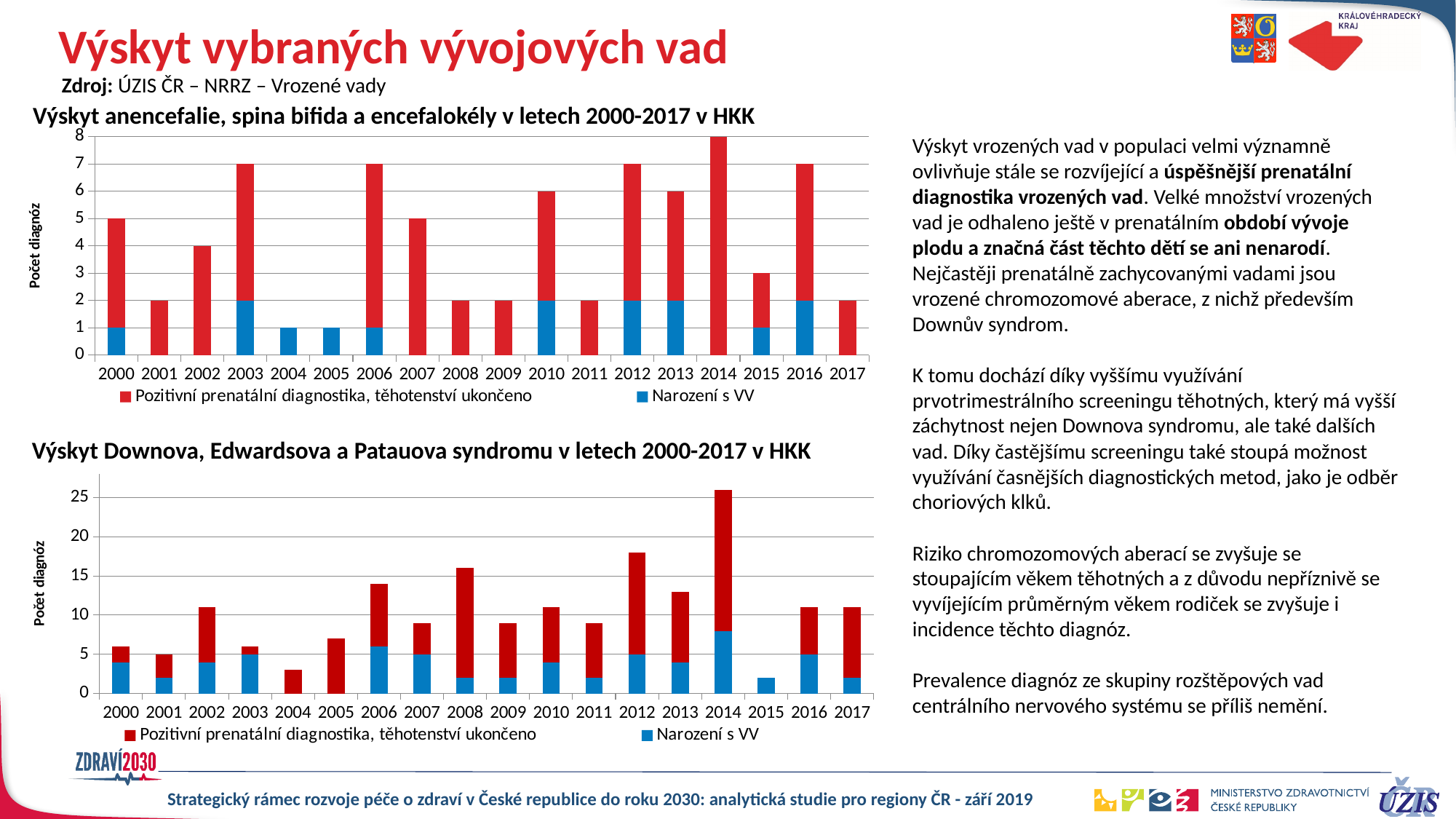
In the top chart (anencefalie, spina bifida a encefalokély), which year has the highest total number of diagnoses? 2014 What type of chart is the top chart, 'Výskyt anencefalie, spina bifida a encefalokély v letech 2000-2017 v HKK'? Stacked bar chart In the bottom chart (Downova, Edwardsova a Patauova syndromu), is the total for 2012 greater or less than 15? greater In the top chart (anencefalie, spina bifida a encefalokély), which total is larger, 2010 or 2011? 2010 In the top chart (anencefalie, spina bifida a encefalokély), what is the total number of diagnoses in 2014? 8 In the top chart (anencefalie, spina bifida a encefalokély), what is the total number of diagnoses in 2004? 1 How many years are shown on the x axis of the bottom chart (Downova, Edwardsova a Patauova syndromu)? 18 In the bottom chart (Downova, Edwardsova a Patauova syndromu), which year has the highest total number of diagnoses? 2014 How many series does the legend of the top chart list? 2 In the top chart (anencefalie, spina bifida a encefalokély), what is the difference between the total for 2014 and the total for 2015? 5 In the bottom chart (Downova, Edwardsova a Patauova syndromu), is the total for 2014 greater or less than 25? greater In the top chart (anencefalie, spina bifida a encefalokély), what is the value of 'Narození s VV' in 2003? 2